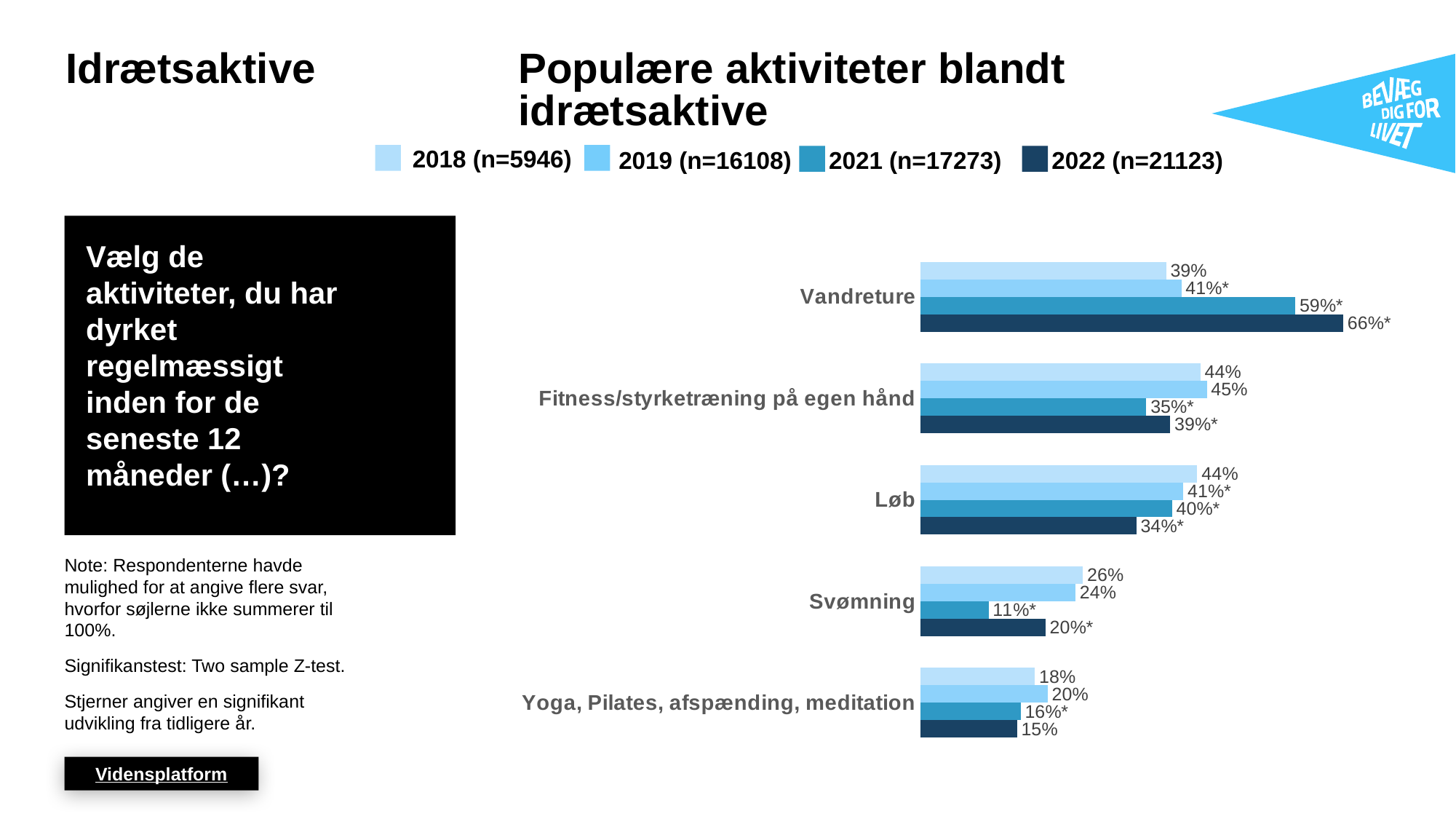
How many activity categories are shown in the chart? 5 Which activity has the highest value in 2022? Vandreture What is the value for Fitness/styrketræning på egen hånd in 2019? 45% Which activity has the lowest value in 2021? Svømning Which is larger for Løb: the 2018 value or the 2022 value? 2018 Do the values for Vandreture rise or fall from 2018 to 2022? rise What is the value for Yoga, Pilates, afspænding, meditation in 2022? 15% What type of chart is shown on the slide? bar chart What is the difference between the 2022 and 2018 values for Vandreture? 27 percentage points How many series does the legend list? 4 What is the value for Vandreture in 2018? 39% What is the value for Svømning in 2018? 26%